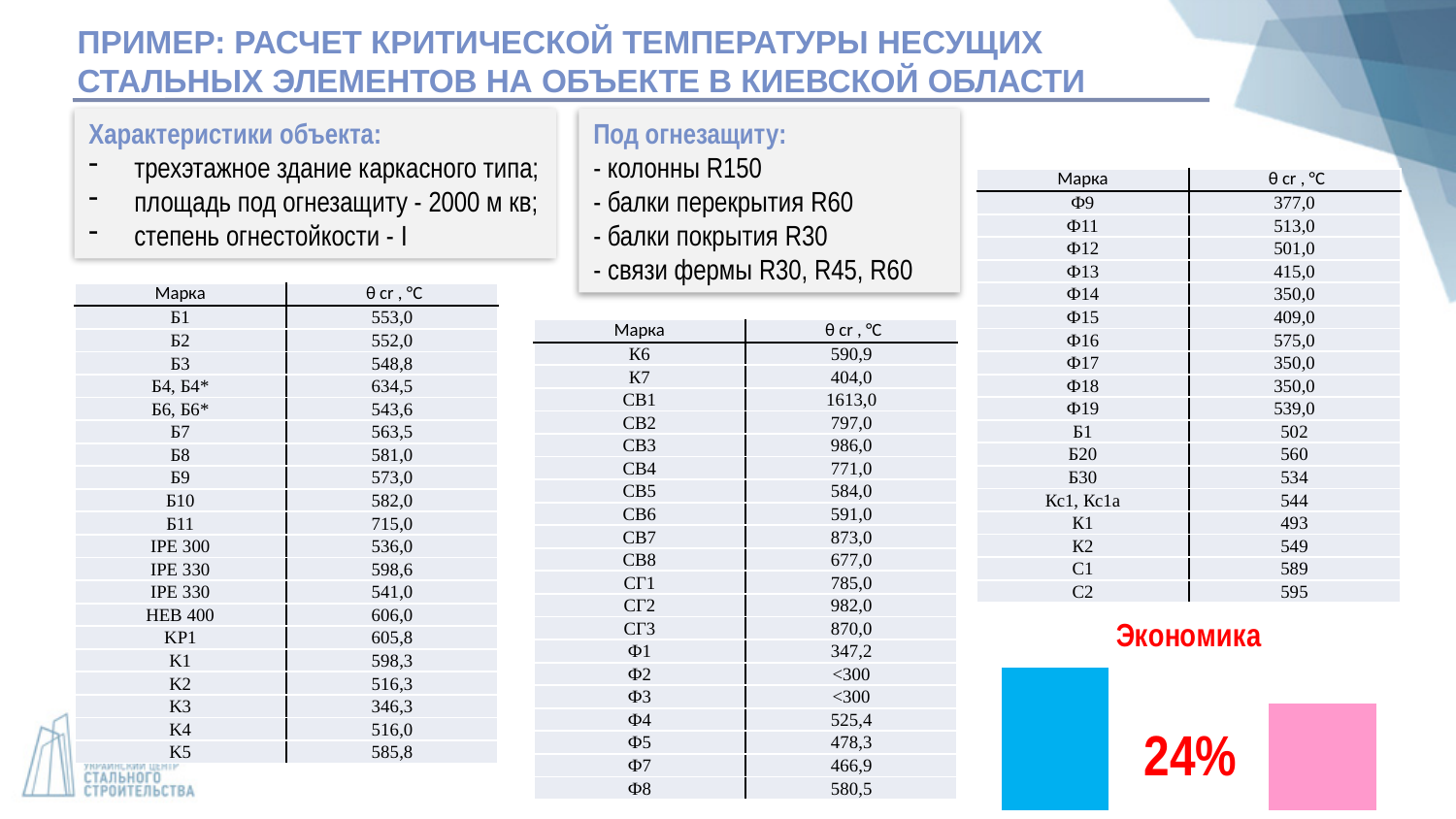
In the "Экономика" chart, which bar is taller, the left (blue) bar or the right (pink) bar? the left (blue) bar What is the title of the chart at the bottom right of the slide? Экономика What kind of chart is shown under the heading "Экономика" at the bottom right of the slide? bar chart Do the bar heights in the "Экономика" chart rise or fall from left to right? fall In the "Экономика" chart, which bar is the shortest? the right (pink) bar What percentage label is printed between the two bars of the "Экономика" chart? 24% How many bars does the "Экономика" chart contain? 2